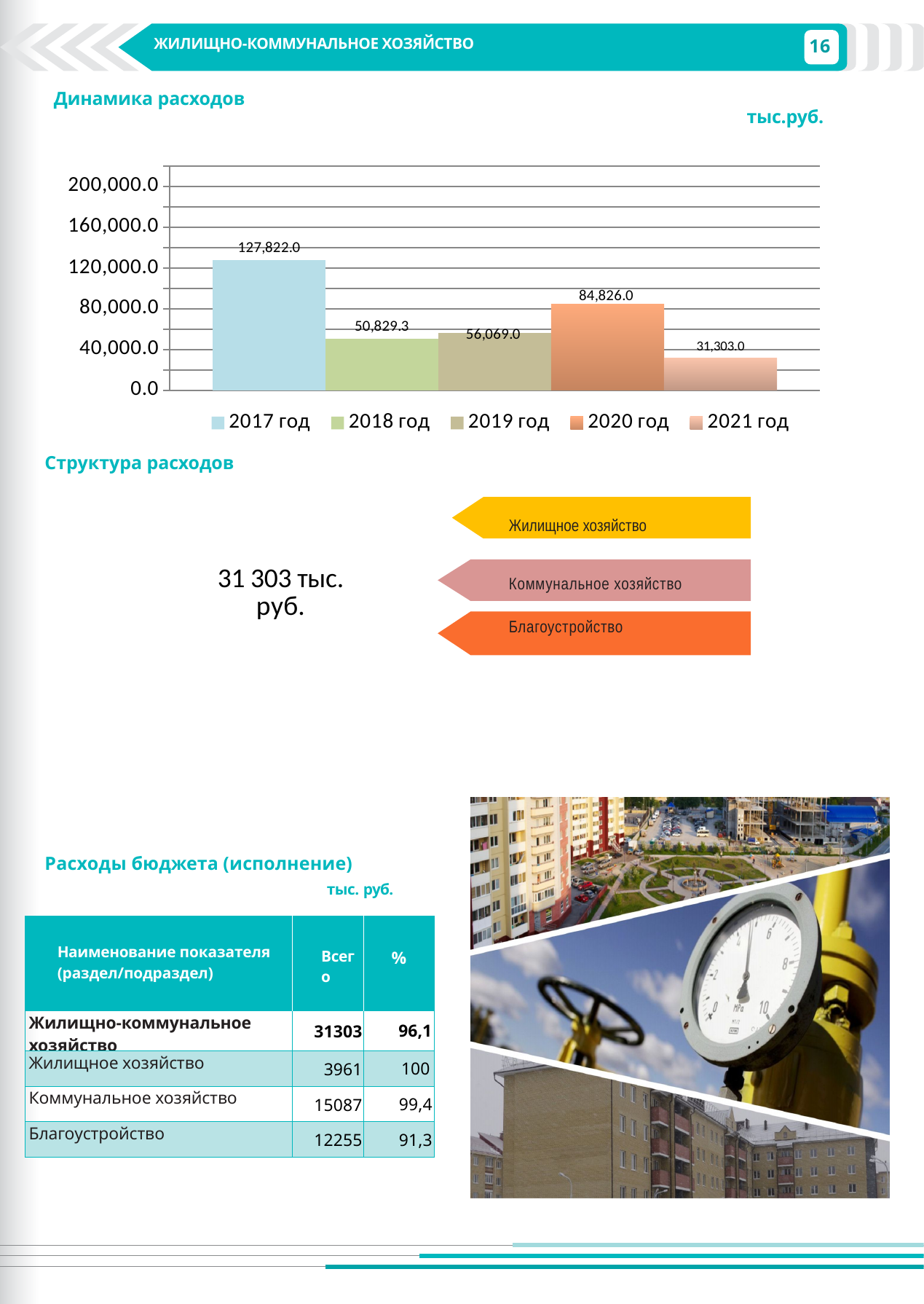
In the "Динамика расходов" chart, what is the difference between the values for 2017 год and 2021 год? 96,519.0 In the "Динамика расходов" chart, what is the value for 2021 год? 31,303.0 In the "Динамика расходов" chart, what is the value for 2017 год? 127,822.0 In the "Динамика расходов" chart, which year has the highest value? 2017 год In the "Динамика расходов" chart, which is larger: the value for 2019 год or 2018 год? 2019 год How many entries does the legend of the "Динамика расходов" chart list? 5 In the "Динамика расходов" chart, which year has the lowest value? 2021 год What type of chart is shown under the heading "Динамика расходов"? bar chart In the "Динамика расходов" chart, what is the difference between the values for 2020 год and 2019 год? 28,757.0 How many bars are plotted in the "Динамика расходов" chart? 5 In the "Динамика расходов" chart, is the value for 2020 год greater or less than 80,000.0? greater In the "Динамика расходов" chart, what is the value for 2018 год? 50,829.3